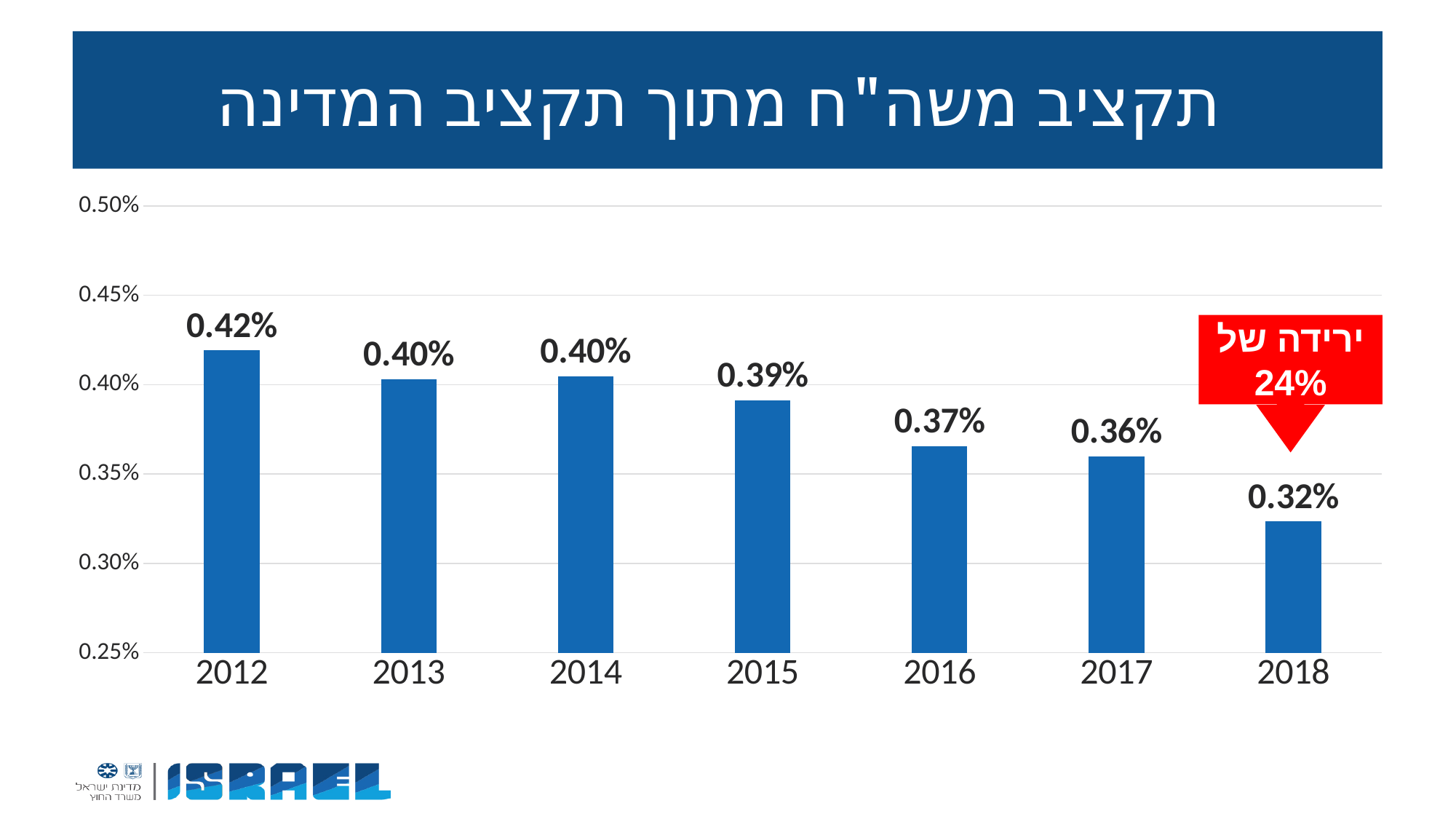
What is the value for 2015? 0.39% How many years are shown on the x axis? 7 Which year has the lowest value? 2018 Do the values generally rise or fall from 2012 to 2018? fall Which is larger, the value for 2016 or the value for 2017? 2016 What is the difference between the values for 2012 and 2018? 0.10% What kind of chart is shown on the slide? bar chart Which year has the highest value? 2012 Is the value for 2018 greater or less than 0.35%? less What is the value for 2018? 0.32% What percentage decrease does the red callout above the 2018 bar state? 24% What is the value for 2012? 0.42%